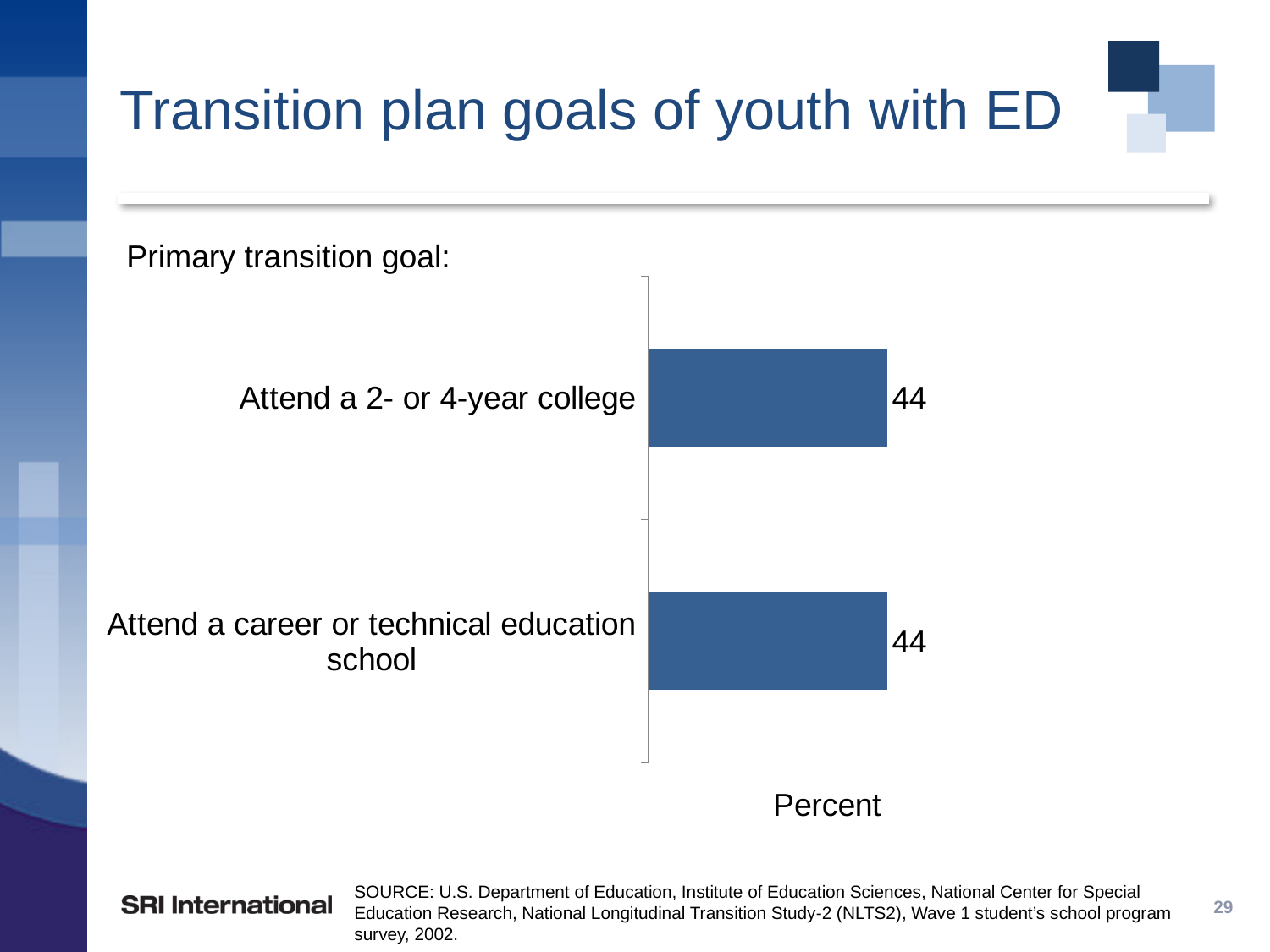
How many categories are plotted in the chart? 2 What is the label on the horizontal axis of the chart? Percent What is the value for "Attend a 2- or 4-year college"? 44 Is the value for "Attend a 2- or 4-year college" the same as the value for "Attend a career or technical education school"? Yes What is the title of the slide containing the chart? Transition plan goals of youth with ED What is the difference between the values for "Attend a 2- or 4-year college" and "Attend a career or technical education school"? 0 What is the value for "Attend a career or technical education school"? 44 What kind of chart is shown on the slide? Bar chart